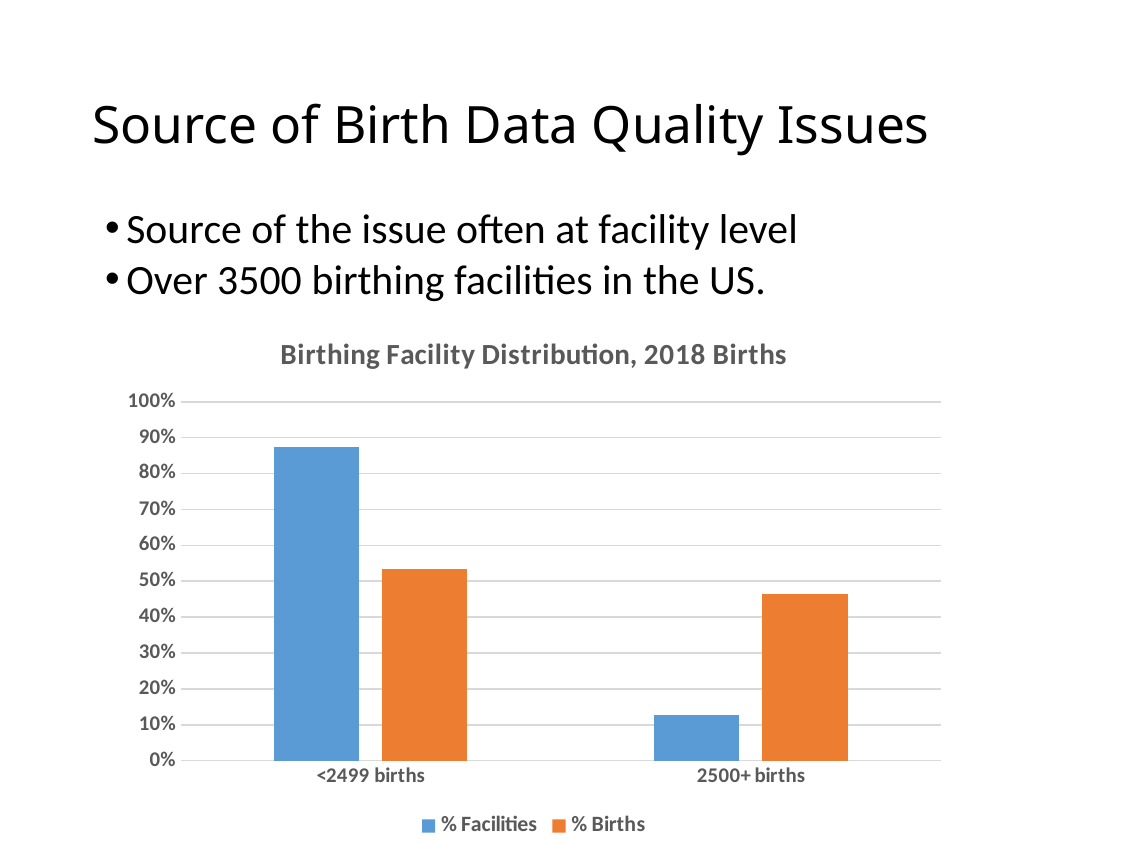
Which category has the lowest value for % Facilities? 2500+ births Is the value of % Births for <2499 births greater or less than 50%? greater For the 2500+ births category, which series has the larger value, % Facilities or % Births? % Births Which series is shown in orange in the chart? % Births What is the title of the chart? Birthing Facility Distribution, 2018 Births Is the value of % Facilities for <2499 births greater or less than 80%? greater What type of chart is shown on the slide? bar chart How many categories are shown on the x axis of the chart? 2 How many series does the chart legend list? 2 Is the value of % Births for 2500+ births greater or less than 50%? less Which category has the higher value for % Facilities? <2499 births